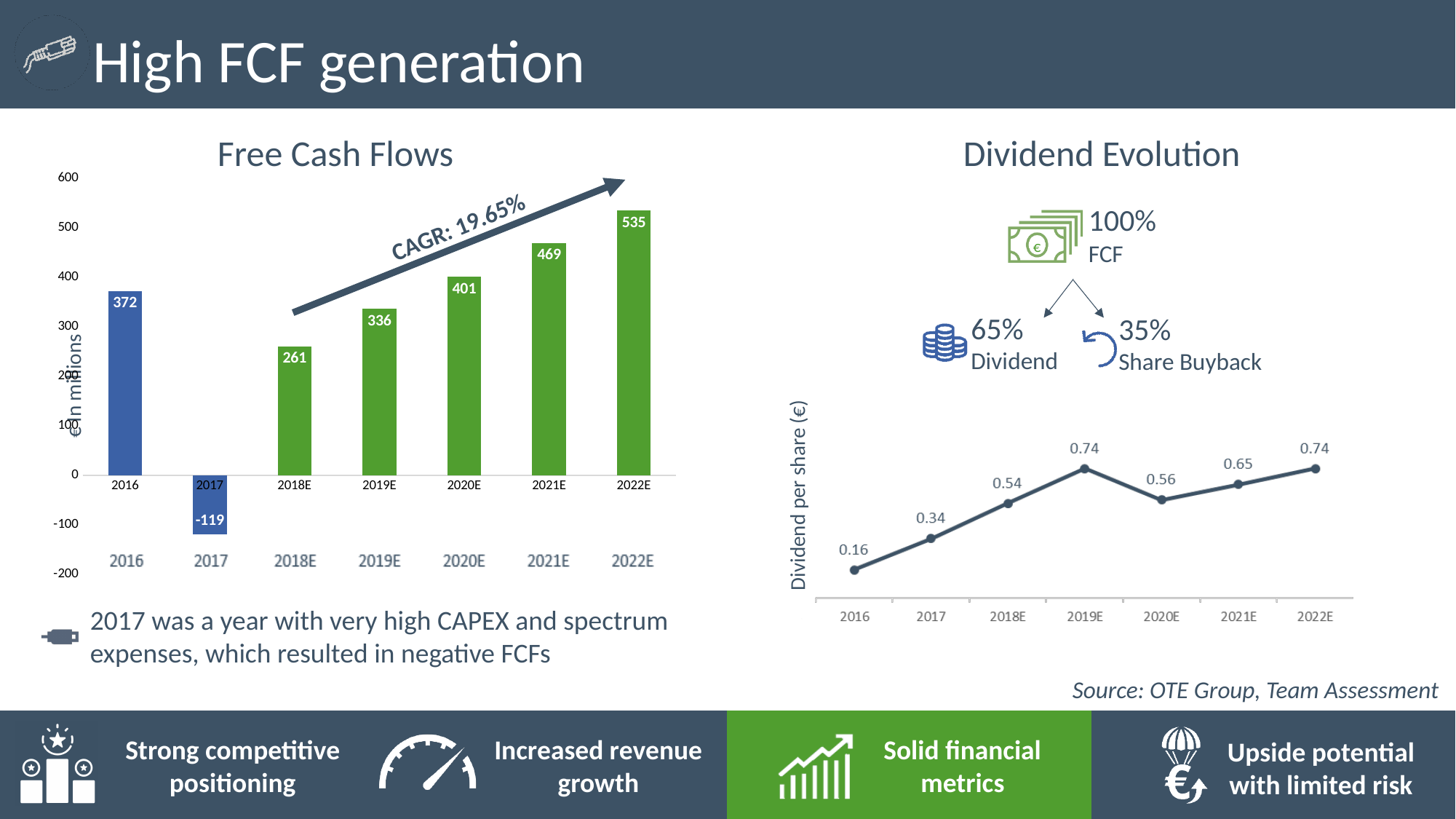
What kind of chart is the Free Cash Flows chart? Bar chart In the Free Cash Flows chart, which year has the highest value? 2022E In the Dividend Evolution chart, what is the dividend per share for 2019E? 0.74 In the Free Cash Flows chart, what is the value for 2022E? 535 In the Free Cash Flows chart, which is larger, the value for 2016 or the value for 2019E? 2016 In the Dividend Evolution chart, what is the difference between the values for 2019E and 2020E? 0.18 In the Free Cash Flows chart, what is the difference between the values for 2022E and 2021E? 66 In the Dividend Evolution chart, what is the dividend per share for 2016? 0.16 In the Free Cash Flows chart, what is the value for 2017? -119 How many bars are plotted in the Free Cash Flows chart? 7 In the Free Cash Flows chart, which year has the lowest value? 2017 What kind of chart is the Dividend Evolution chart? Line chart